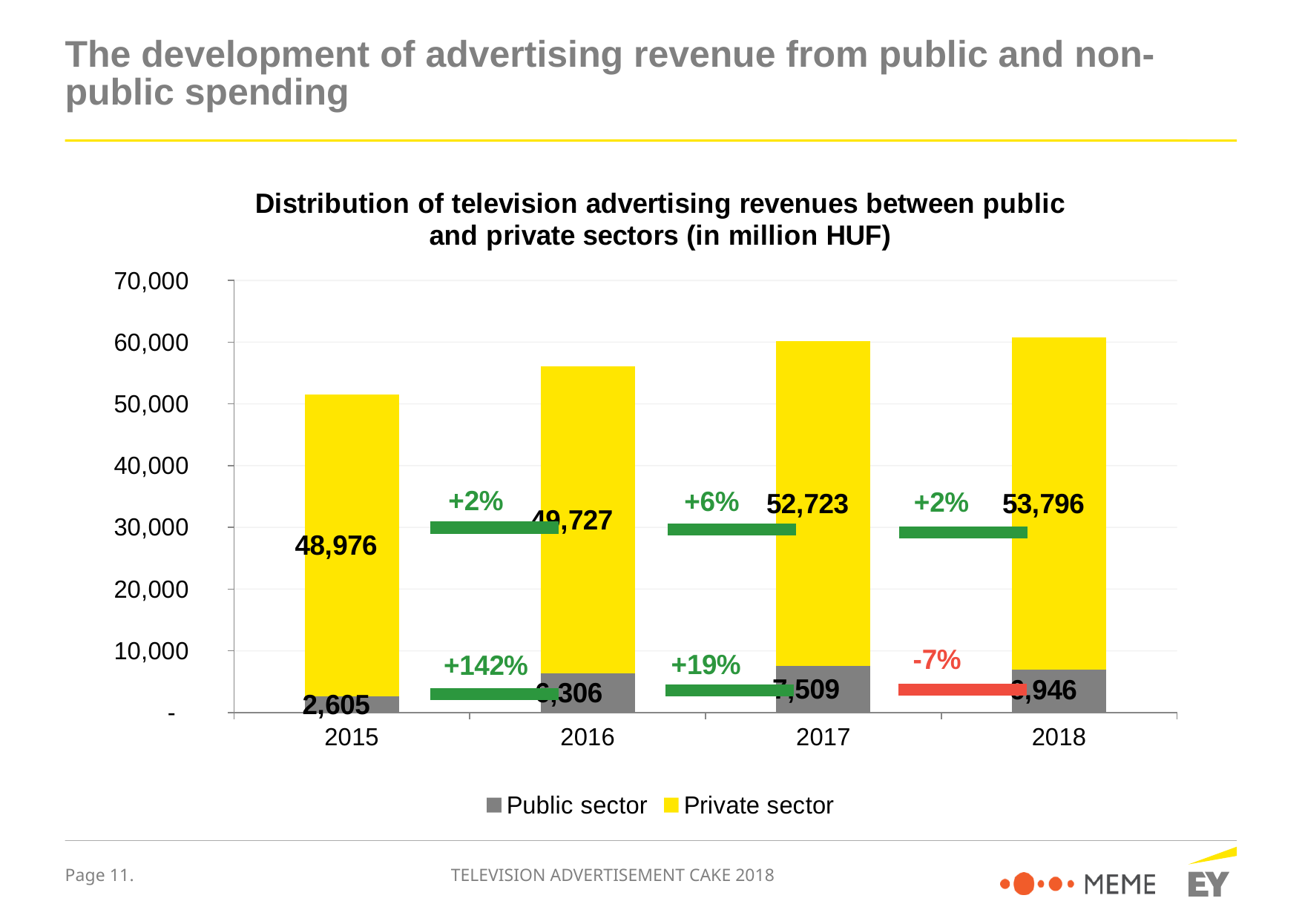
What is the total of the stacked bar for 2015? 51,581 What is the Private sector value for 2018? 53,796 What is the Private sector value for 2015? 48,976 In which year is the Private sector value highest? 2018 Which year shows a negative percentage change for the Public sector? 2018 What kind of chart is shown on the slide? Bar chart In which year is the Private sector value lowest? 2015 What is the Public sector value for 2015? 2,605 What is the difference between the Private sector values for 2018 and 2015? 4,820 How many years are shown on the x axis? 4 How many series does the legend list? 2 Is the total of the stacked bar for 2016 greater or less than 50,000? greater